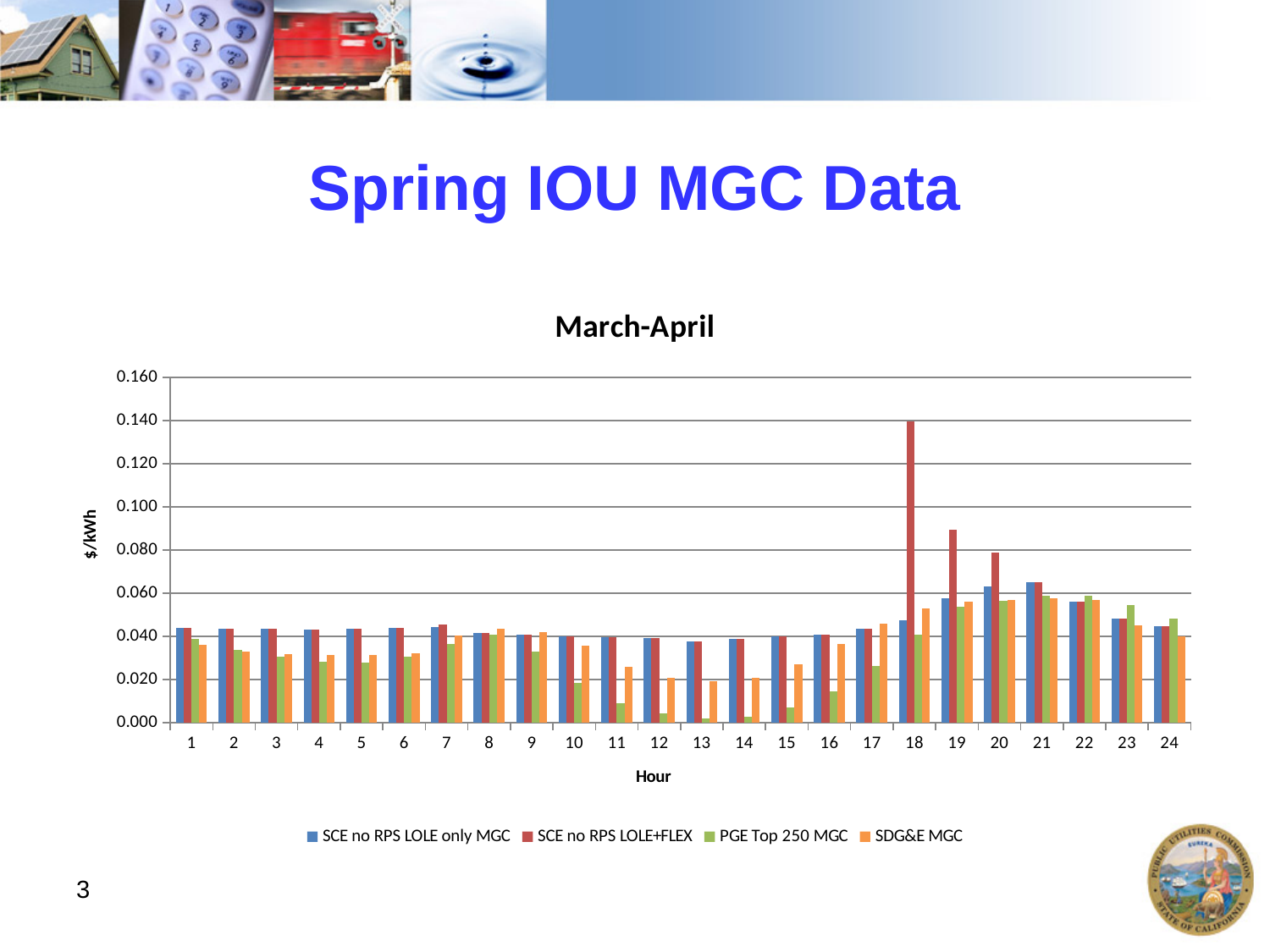
What is the label of the y axis? $/kWh Is the SCE no RPS LOLE+FLEX value at hour 18 greater or less than 0.120? greater At hour 18, which is larger: SCE no RPS LOLE+FLEX or PGE Top 250 MGC? SCE no RPS LOLE+FLEX Is the SDG&E MGC value at hour 1 greater or less than 0.040? less At hour 11, which is larger: SDG&E MGC or PGE Top 250 MGC? SDG&E MGC Is the PGE Top 250 MGC value at hour 13 greater or less than 0.020? less At which hour is the SCE no RPS LOLE+FLEX value highest? 18 What kind of chart is shown on the slide? bar chart How many series does the legend list? 4 How many hours are shown along the x axis? 24 What is the title of the chart? March-April